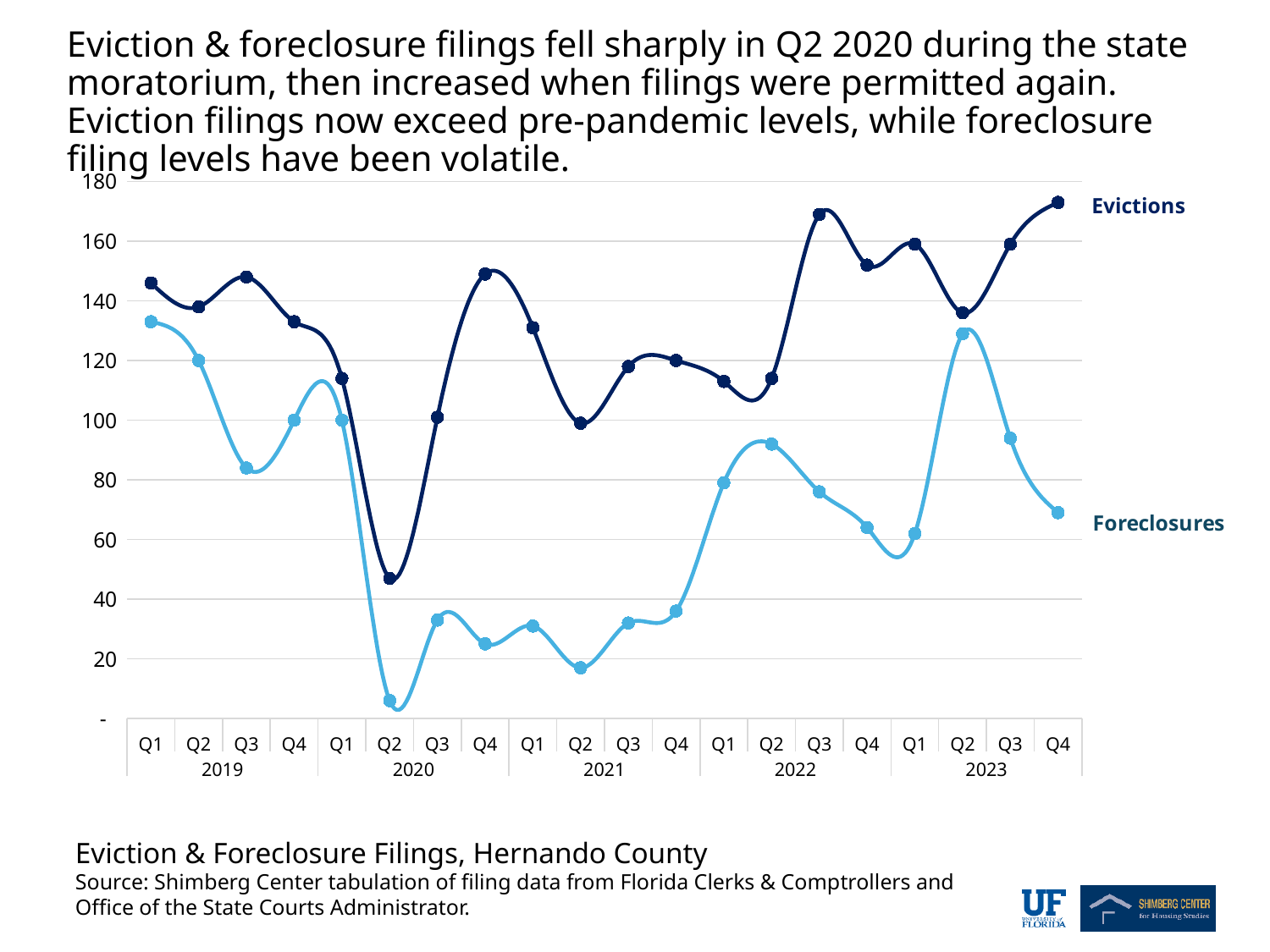
In Q1 2019, which series has the higher value, Evictions or Foreclosures? Evictions How many quarterly data points does each line have? 20 What kind of chart is shown on the slide? line chart Is the value for Evictions in Q4 2023 greater or less than 160? greater Is the value for Foreclosures in Q2 2020 greater or less than 20? less Do foreclosure filings rise or fall from Q2 2023 to Q4 2023? fall In which quarter do eviction filings reach their lowest point? Q2 2020 How many series are plotted on the chart? 2 In which quarter do foreclosure filings reach their lowest point? Q2 2020 Is the value for Evictions in Q2 2020 greater or less than 60? less What is the title of the chart given at the bottom of the slide? Eviction & Foreclosure Filings, Hernando County